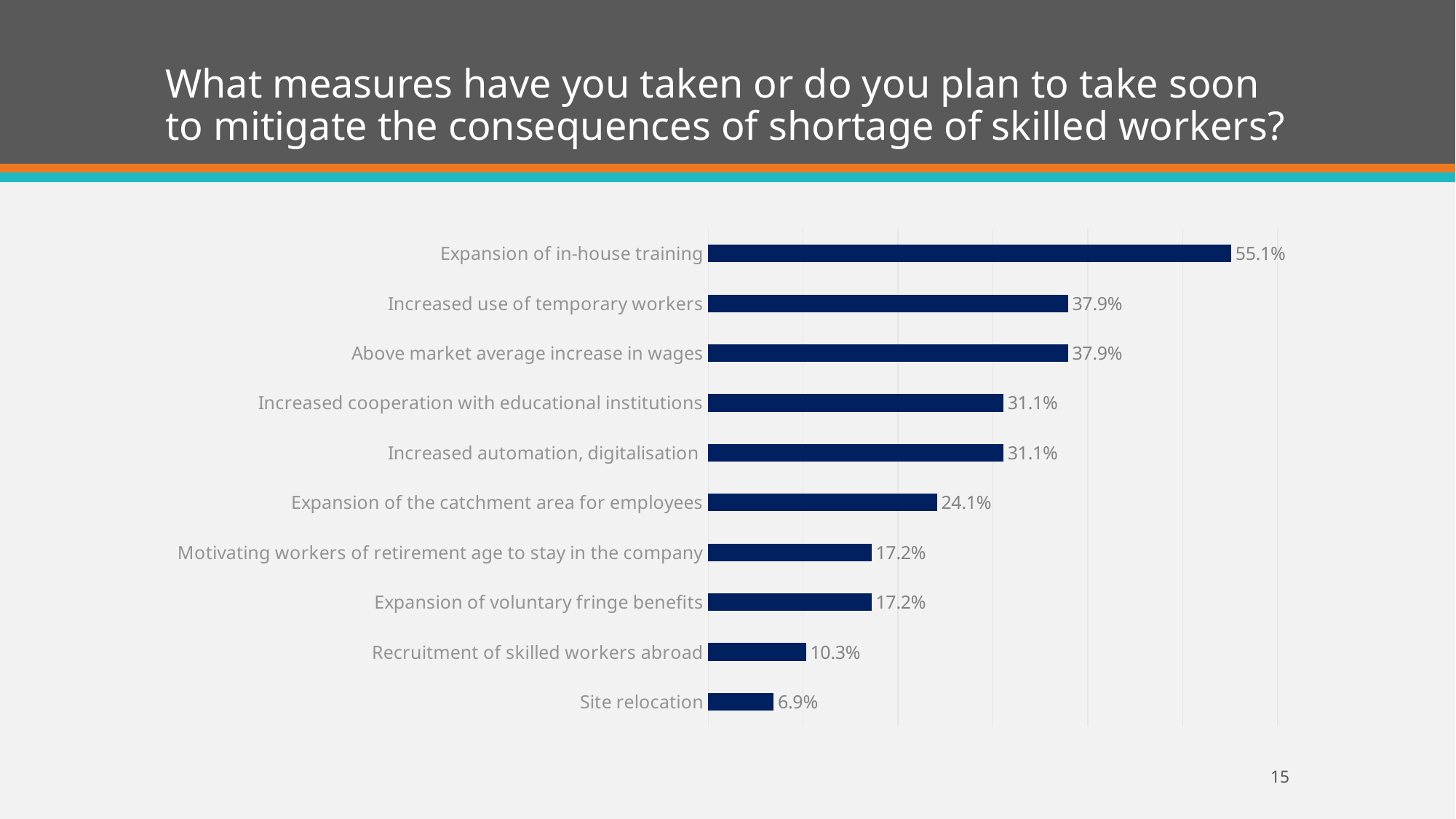
What is the value for Site relocation? 6.9% How many measures are shown in the chart? 10 Which measure has the highest value? Expansion of in-house training What is the difference between Expansion of in-house training and Increased use of temporary workers? 17.2% What is the value for Increased cooperation with educational institutions? 31.1% Which is larger: Increased automation, digitalisation or Expansion of voluntary fringe benefits? Increased automation, digitalisation What is the value for Recruitment of skilled workers abroad? 10.3% What is the difference between Expansion of the catchment area for employees and Site relocation? 17.2% Which measure has the lowest value? Site relocation What kind of chart is shown on the slide? Bar chart What is the value for Expansion of the catchment area for employees? 24.1% What is the value for Expansion of in-house training? 55.1%